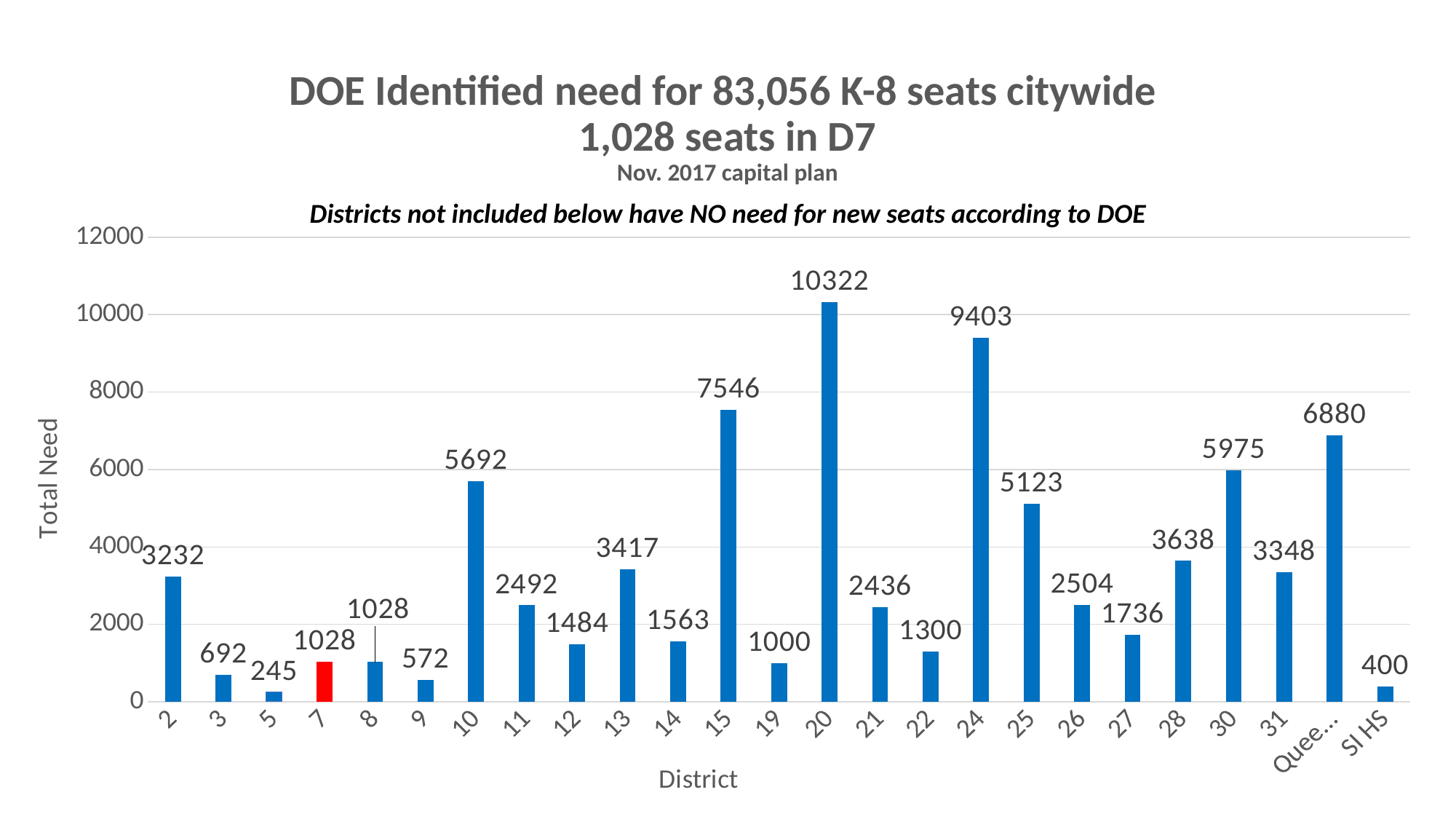
What is the difference in total need between district 20 and district 24? 919 Which has a larger total need, district 13 or district 28? District 28 How many districts are shown on the x axis? 25 Which bar is highlighted in red? District 7 What kind of chart is shown on the slide? Bar chart Which district has the lowest total need? 5 Which district has the highest total need? 20 What is the total need for district 20? 10322 What is the total need for SI HS? 400 What is the total need for district 15? 7546 What is the total need for district 7? 1028 What is the difference in total need between district 10 and district 30? 283